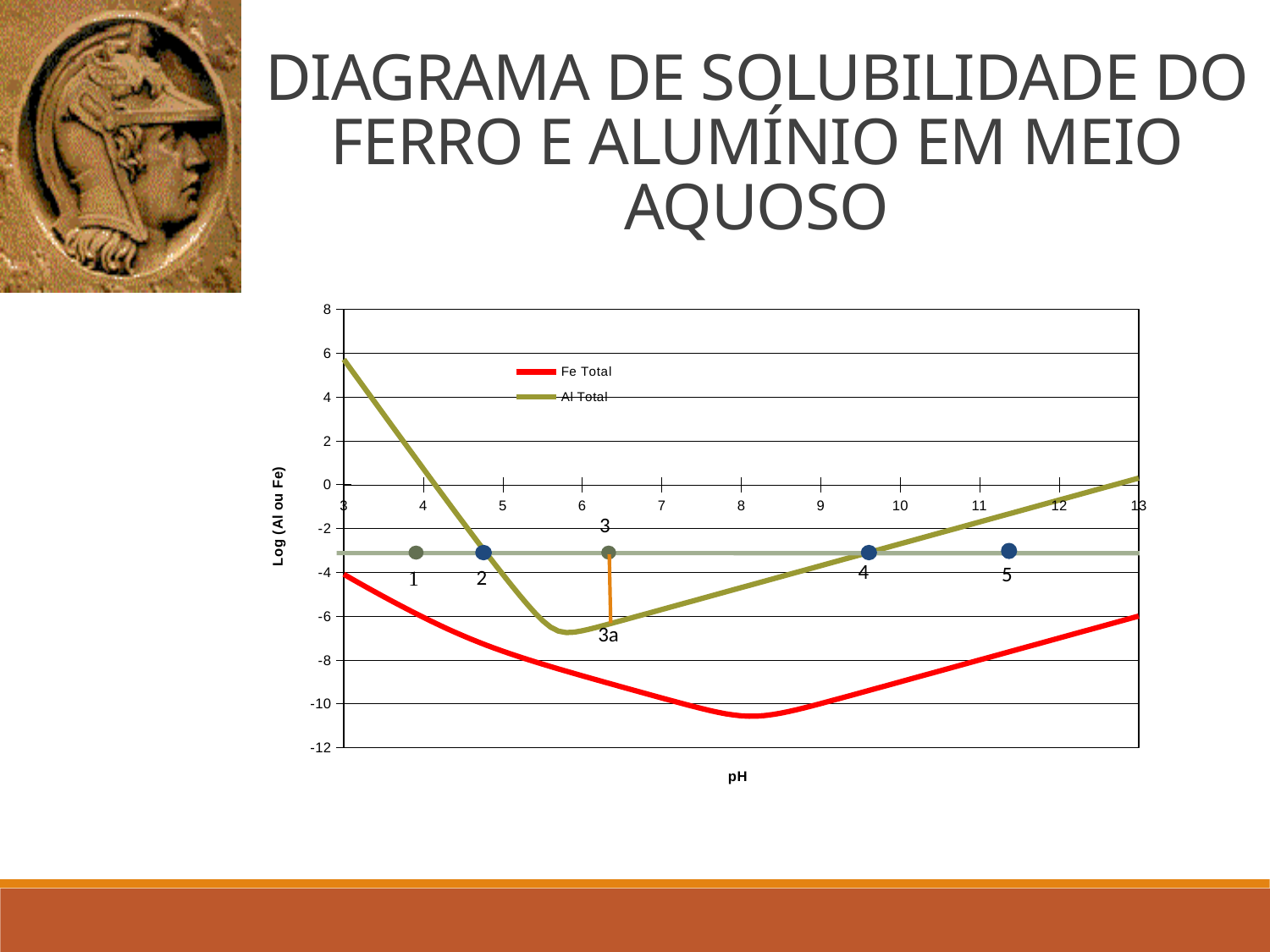
What kind of chart is shown on the slide? line chart Is the Al Total value at pH 3 greater or less than 4? greater What are the two series named in the chart legend? Fe Total and Al Total What is the label of the x axis? pH Is the Fe Total value at pH 3 greater or less than -2? less Is the Al Total value at pH 6 greater or less than -4? less Which series is drawn in red? Fe Total How many series does the chart legend list? 2 Does the Al Total curve rise or fall as pH increases from 8 to 13? rise Does the Fe Total curve rise or fall as pH increases from 3 to 8? fall At pH 8, which series has the higher value, Fe Total or Al Total? Al Total